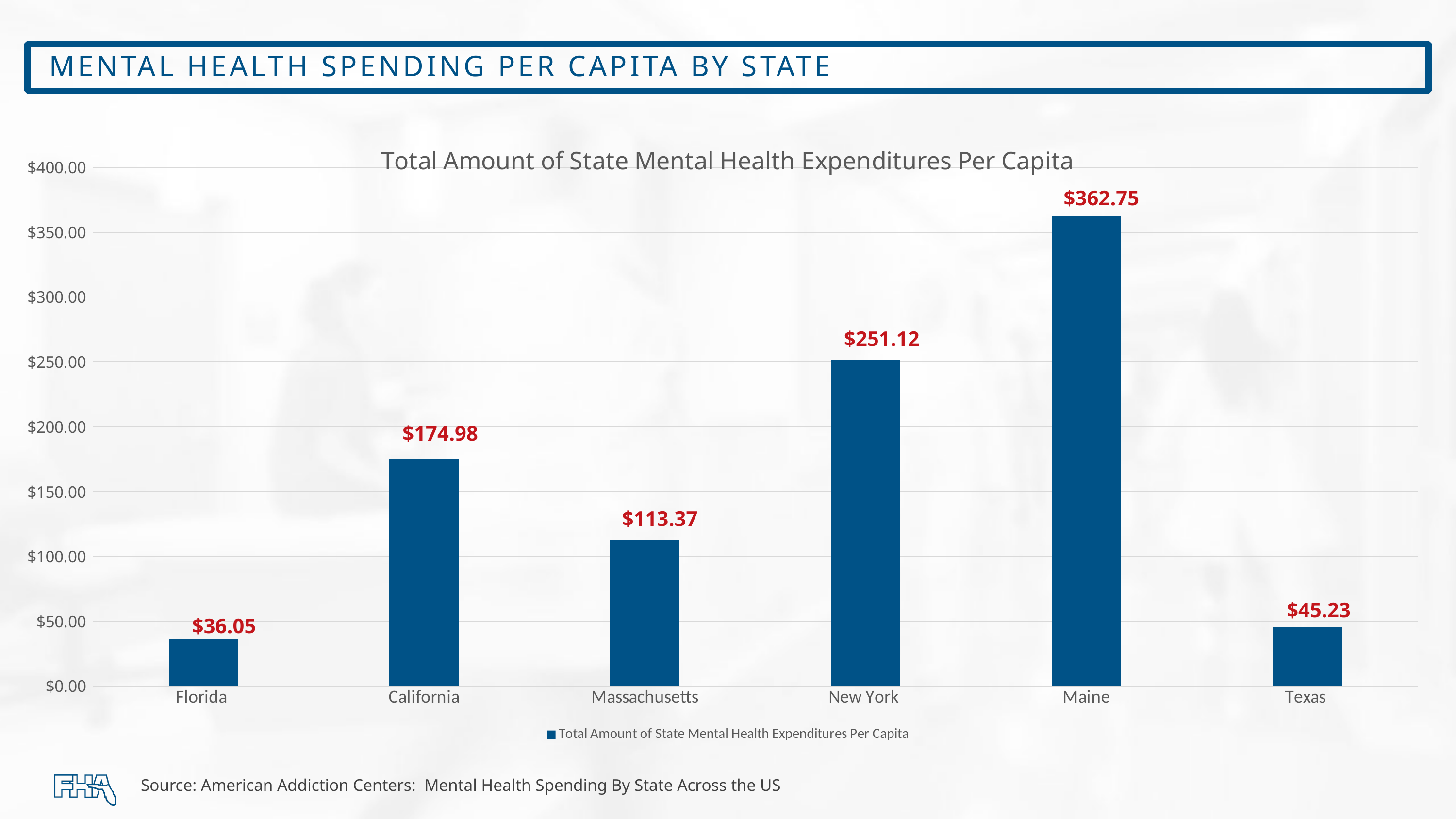
What is the mental health expenditure per capita for Florida? $36.05 Which state has the highest mental health expenditure per capita? Maine What is the mental health expenditure per capita for Maine? $362.75 Is the value for New York greater or less than $250.00? greater What is the difference between the per capita expenditures of New York and California? $76.14 Which state has a higher per capita expenditure, California or Massachusetts? California What is the mental health expenditure per capita for Massachusetts? $113.37 What is the difference between the per capita expenditures of Texas and Florida? $9.18 Which state has the lowest mental health expenditure per capita? Florida What kind of chart is shown on the slide? Bar chart What is the title of the chart? Total Amount of State Mental Health Expenditures Per Capita How many states are shown in the chart? 6